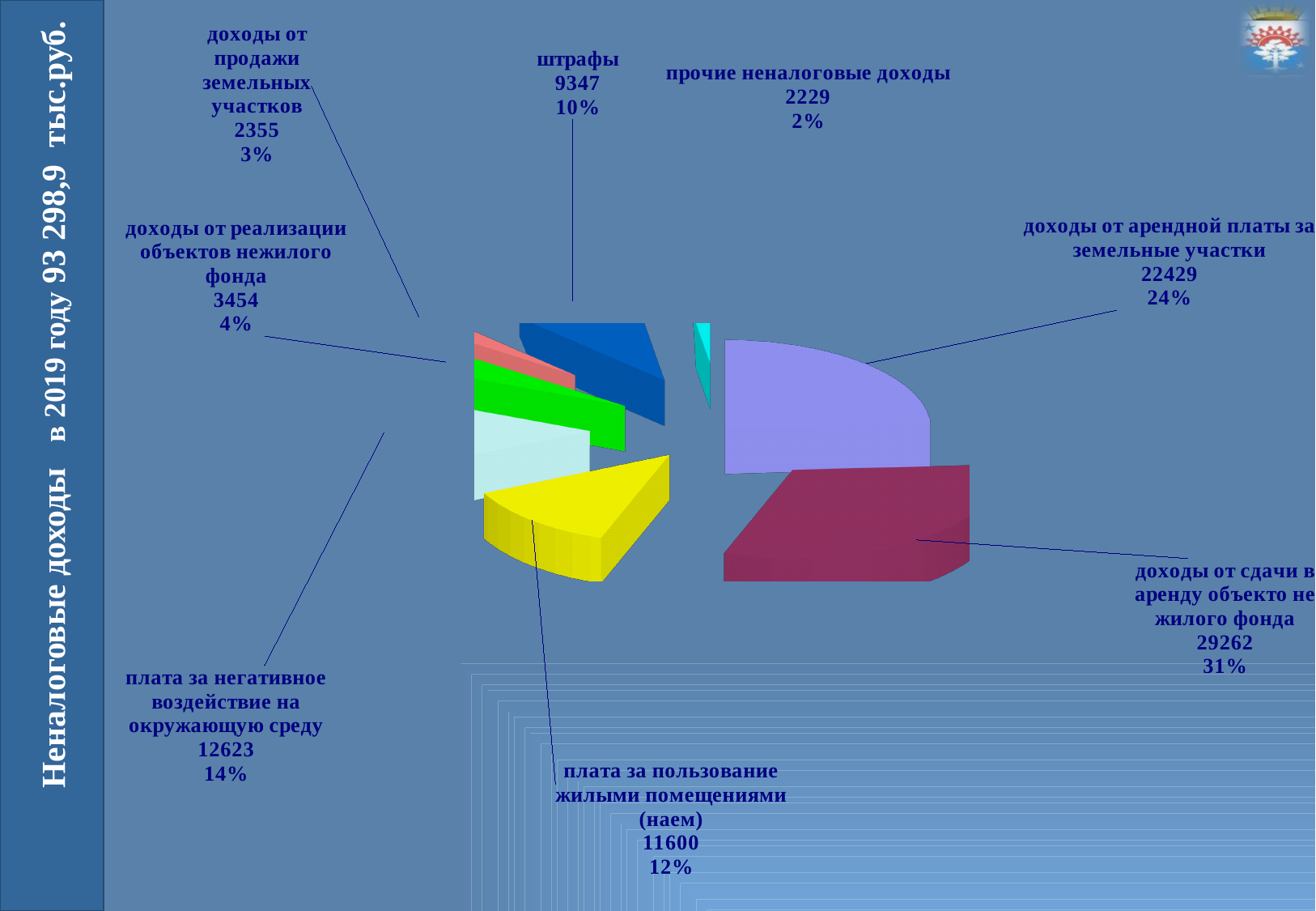
Which category has the smallest value? прочие неналоговые доходы What kind of chart is shown on the slide? pie chart What is the value for доходы от реализации объектов нежилого фонда? 3454 Which category has the largest value? доходы от сдачи в аренду объекто нежилого фонда How many categories (slices) does the pie chart show? 8 What is the value for штрафы? 9347 Which is larger: плата за негативное воздействие на окружающую среду or плата за пользование жилыми помещениями (наем)? плата за негативное воздействие на окружающую среду What percentage share does доходы от арендной платы за земельные участки have? 24% What total amount of non-tax revenues in 2019 is stated in the slide title? 93 298,9 тыс.руб. What percentage share does доходы от продажи земельных участков have? 3% What is the difference between the values for доходы от сдачи в аренду объекто нежилого фонда and доходы от арендной платы за земельные участки? 6833 What is the value for плата за негативное воздействие на окружающую среду? 12623